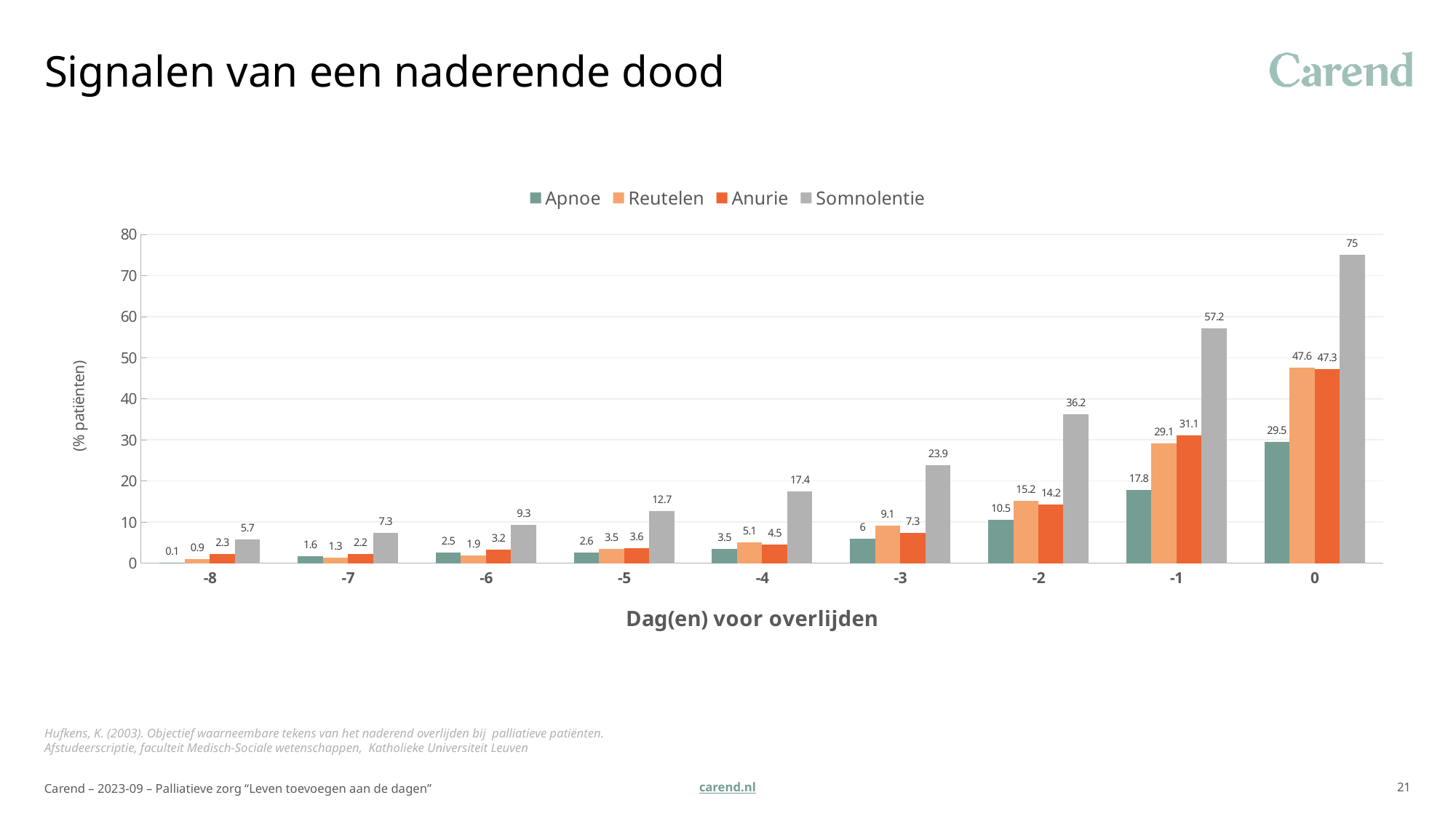
At which day is the Somnolentie value highest? 0 At which day is the Apnoe value lowest? -8 What is the value for Somnolentie at day 0? 75 How many day categories are shown on the x axis? 9 What kind of chart is shown on the slide? Bar chart What is the value for Reutelen at day -3? 9.1 What is the difference between the Somnolentie values at day 0 and day -1? 17.8 Which is larger at day -2: Reutelen or Anurie? Reutelen How many series does the legend list? 4 What is the value for Anurie at day -2? 14.2 What is the value for Apnoe at day -1? 17.8 Do the Somnolentie values rise or fall from day -8 to day 0? Rise